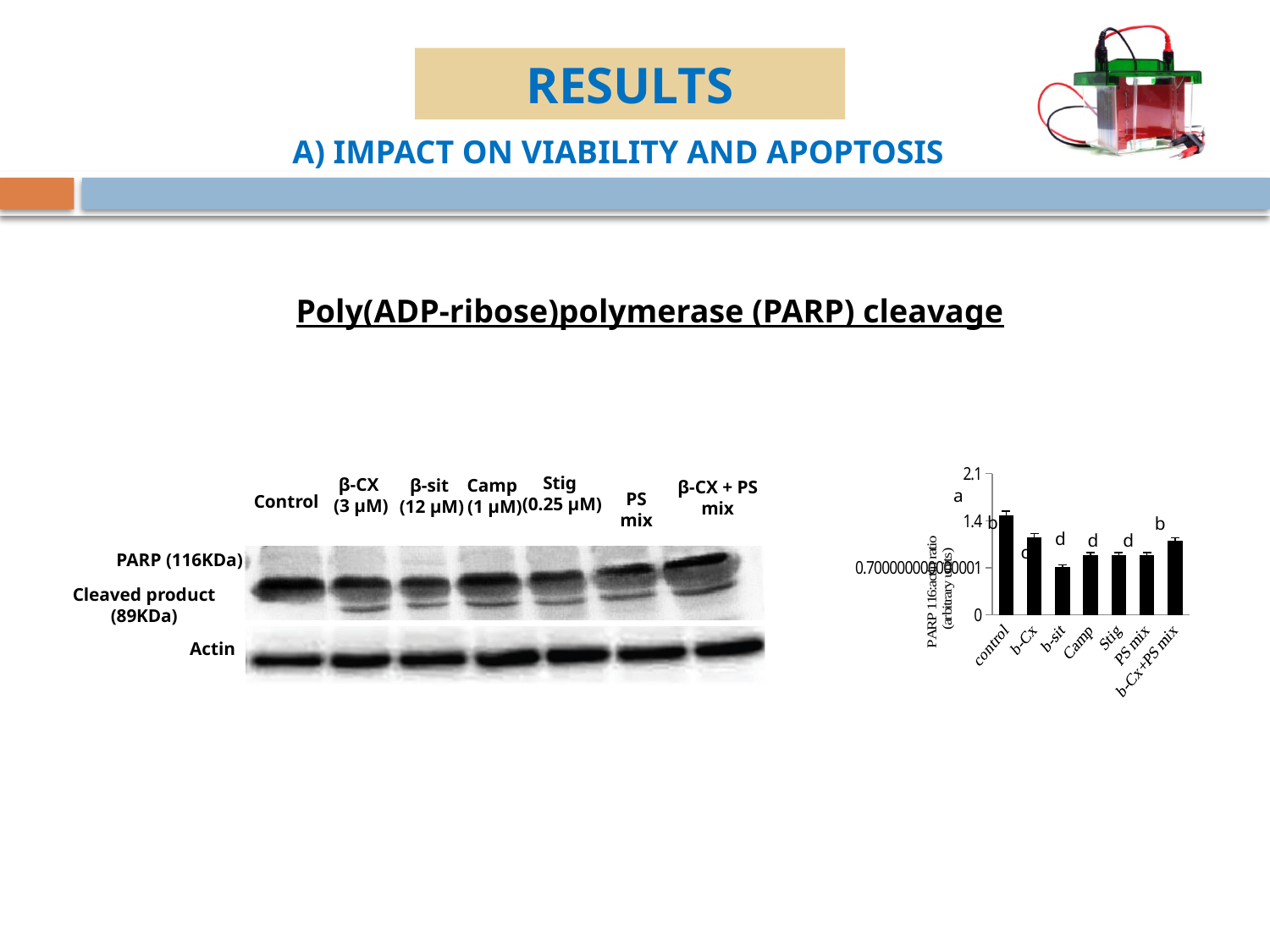
In the bar chart, which is larger, the value for control or the value for Camp? control Is the value for control in the bar chart greater or less than 2.1? less What is the label of the last category on the x axis of the bar chart? b-Cx+PS mix What is the highest tick value shown on the y axis of the bar chart? 2.1 Is the value for Camp in the bar chart greater or less than 1.4? less In the bar chart, which is larger, the value for b-Cx or the value for b-sit? b-Cx Which category has the highest bar in the bar chart? control Which category has the lowest bar in the bar chart? b-sit How many categories are plotted on the bar chart? 7 What kind of chart is shown on the right of the slide? bar chart Is the value for b-sit in the bar chart greater or less than 1.4? less In the bar chart, which is larger, the value for control or the value for b-sit? control